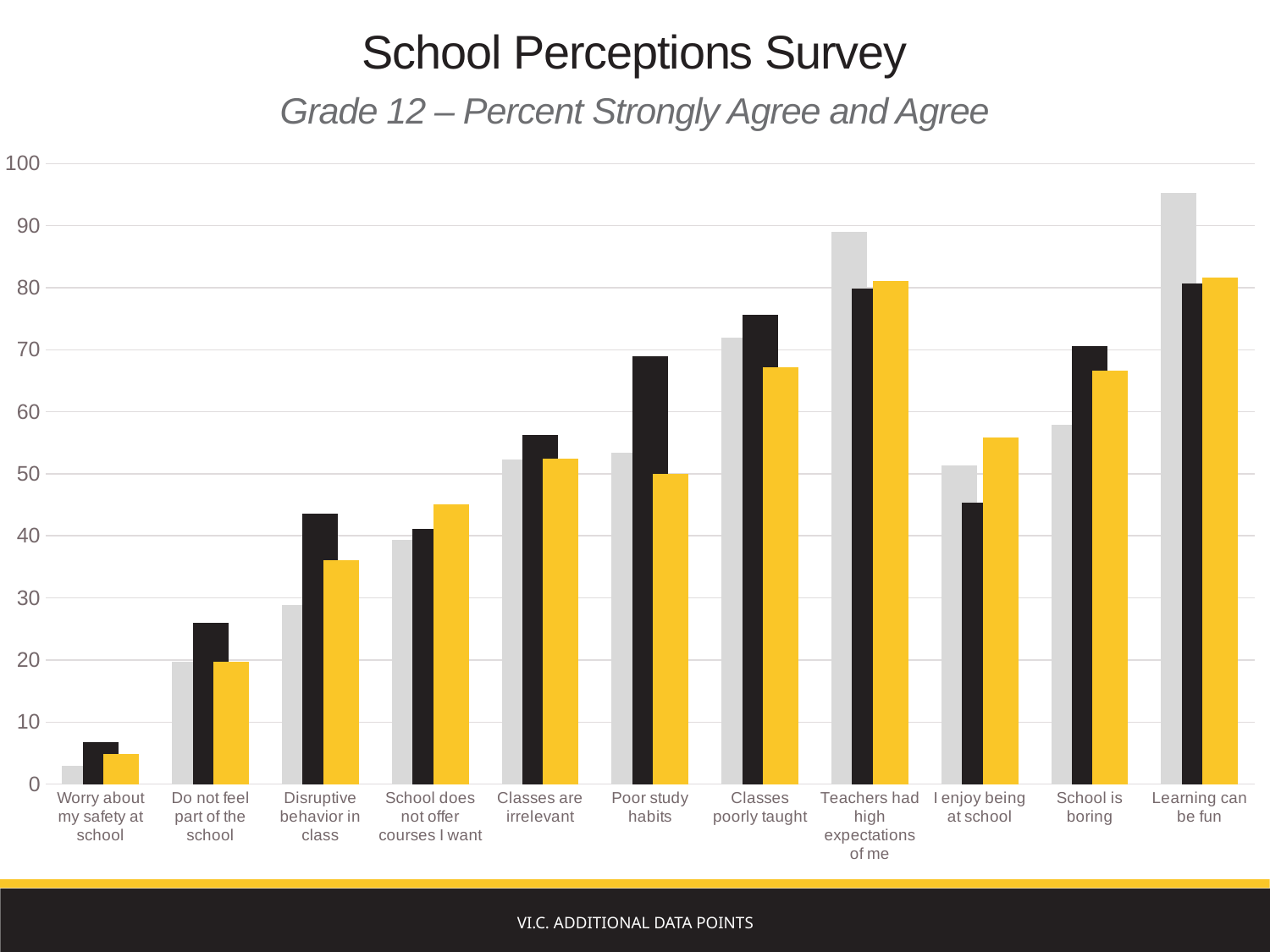
Is the grey bar for 'Teachers had high expectations of me' greater or less than 80? greater Which survey statement has the shortest bars overall? Worry about my safety at school Is the black bar for 'Poor study habits' greater or less than 60? greater Which survey statement has the tallest grey bar? Learning can be fun How many bars are plotted for each survey statement? 3 Is the yellow bar for 'Disruptive behavior in class' greater or less than 40? less How many survey statements (categories) are shown along the x axis? 11 For 'I enjoy being at school', which is taller: the black bar or the yellow bar? the yellow bar What kind of chart is shown on the slide? bar chart For 'Teachers had high expectations of me', which is taller: the grey bar or the black bar? the grey bar What is the subtitle of the chart? Grade 12 – Percent Strongly Agree and Agree